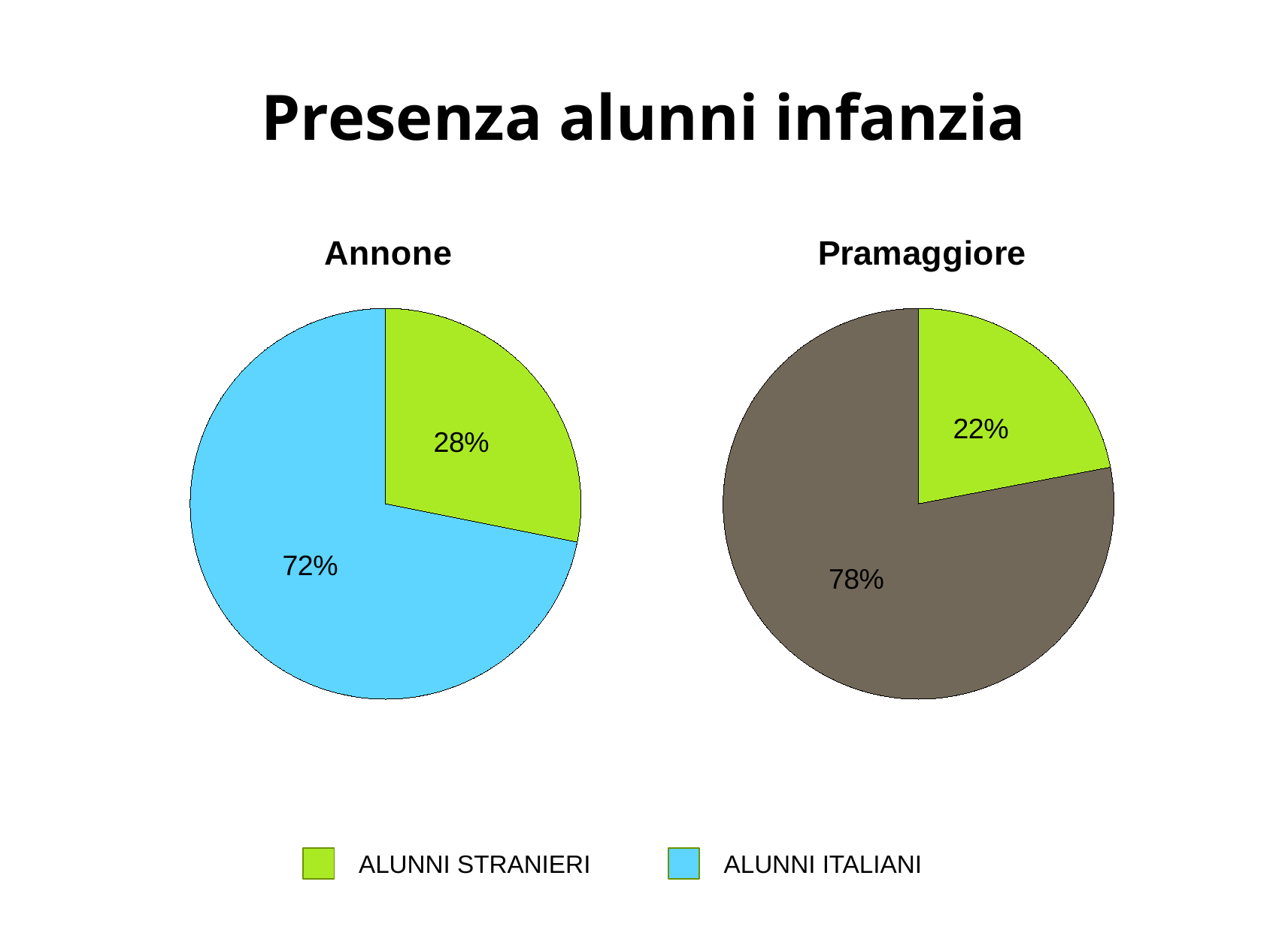
How many slices does the Pramaggiore chart have? 2 In the Annone chart, what share of the pie is ALUNNI STRANIERI? 28% In the Annone chart, which slice is the smallest? ALUNNI STRANIERI In the Annone chart, which slice is the largest? ALUNNI ITALIANI In the Pramaggiore chart, what share of the pie is ALUNNI STRANIERI? 22% In the Pramaggiore chart, what percentage is shown on the largest slice? 78% What is the difference between the ALUNNI STRANIERI share in Annone and in Pramaggiore? 6% How many entries does the legend list? 2 What kind of chart is the Annone chart? Pie chart Which chart has the larger ALUNNI STRANIERI share, Annone or Pramaggiore? Annone What is the difference between the ALUNNI ITALIANI and ALUNNI STRANIERI shares in the Annone chart? 44% In the Annone chart, what share of the pie is ALUNNI ITALIANI? 72%